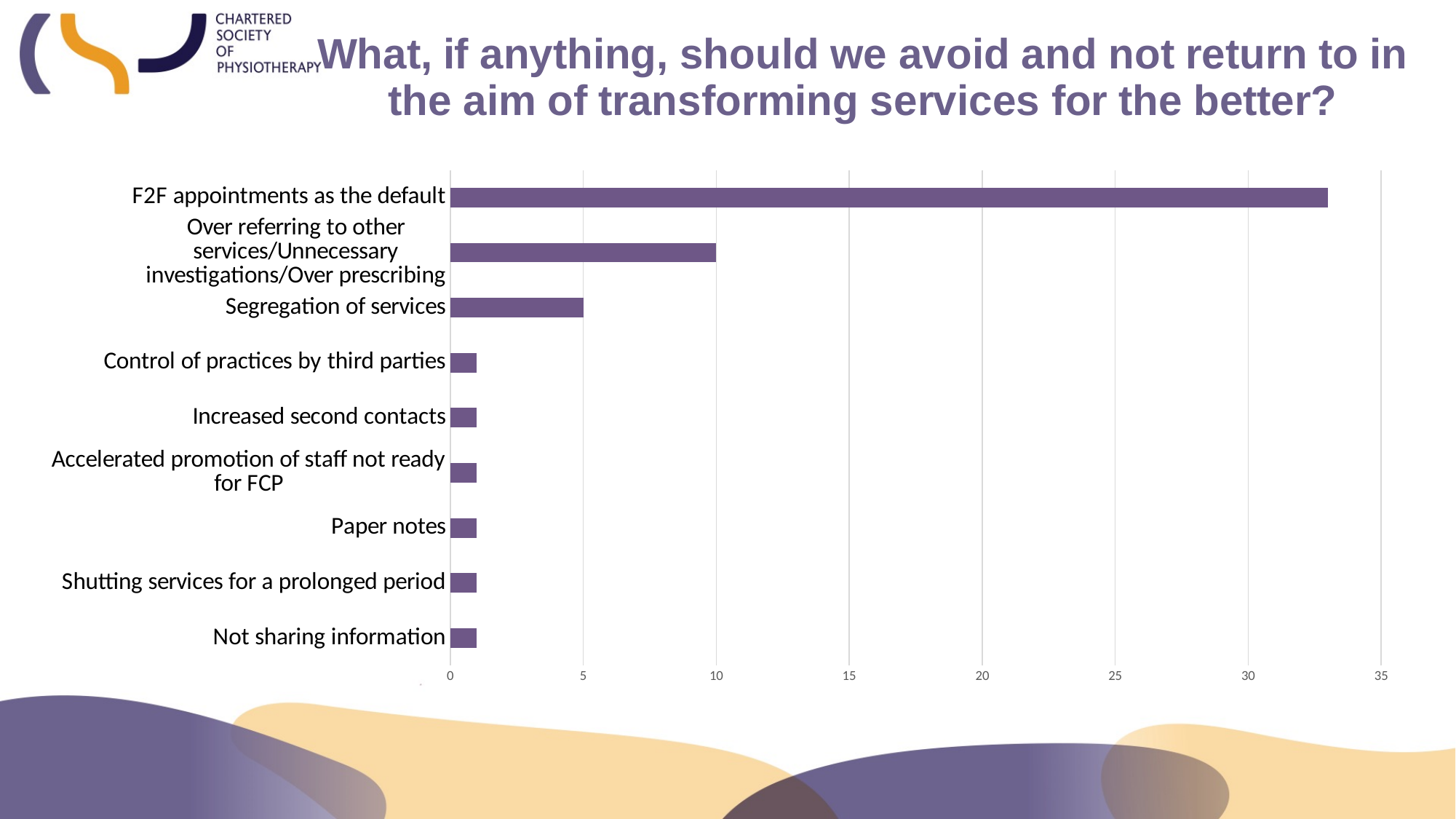
What is the highest value shown on the horizontal axis of the chart? 35 Is the value for F2F appointments as the default greater or less than 30? greater What is the difference between the values for Over referring to other services/Unnecessary investigations/Over prescribing and Segregation of services? 5 Which category has the highest value in the chart? F2F appointments as the default Which is larger: the value for Segregation of services or the value for Not sharing information? Segregation of services How many categories are plotted in the chart? 9 Which is larger: the value for F2F appointments as the default or the value for Over referring to other services/Unnecessary investigations/Over prescribing? F2F appointments as the default Is the value for Paper notes greater or less than 5? less What kind of chart is shown on the slide? bar chart What is the value for Segregation of services? 5 What is the value for Over referring to other services/Unnecessary investigations/Over prescribing? 10 Is the value for Control of practices by third parties greater or less than 5? less